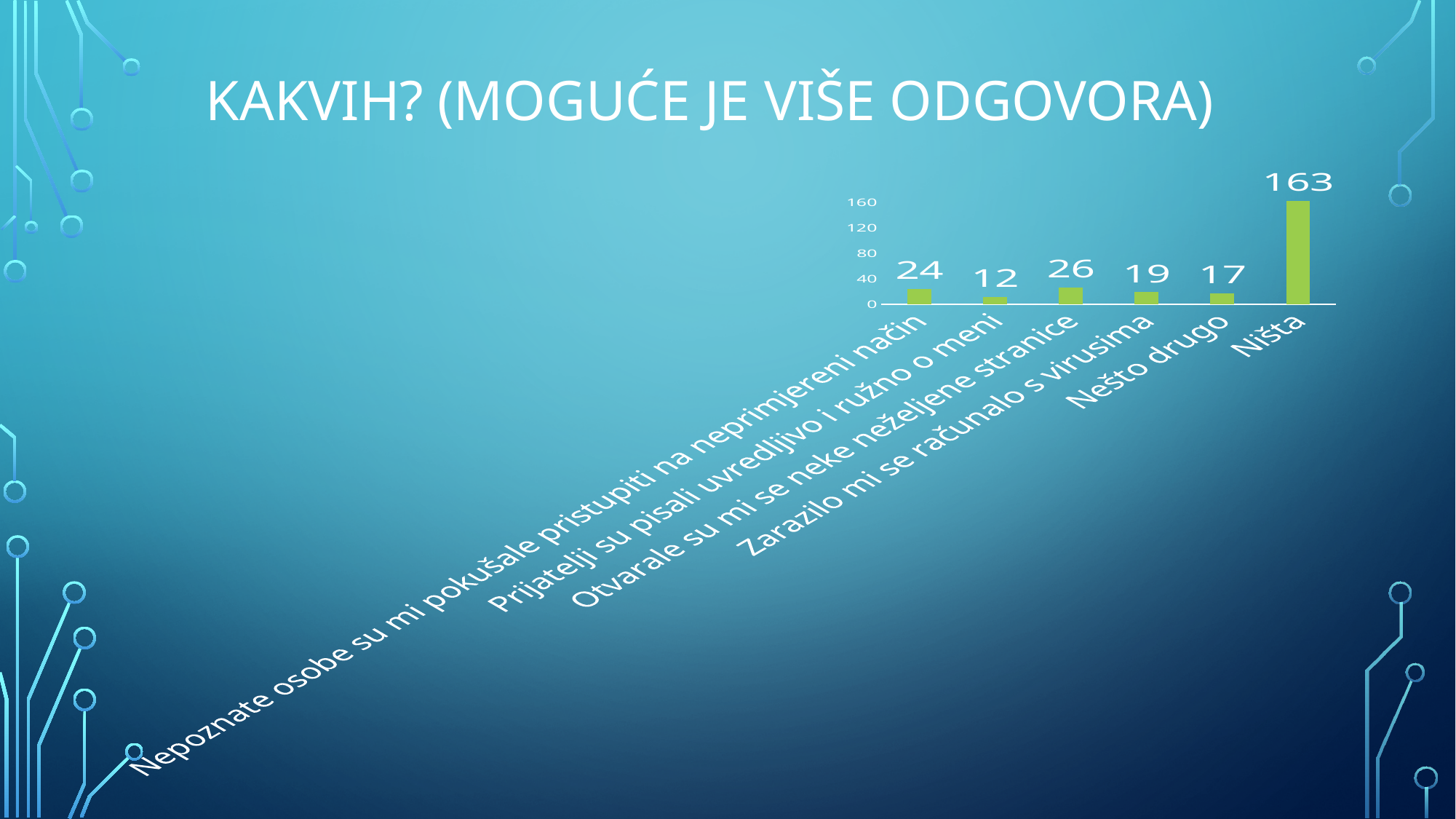
What is the value for "Zarazilo mi se računalo s virusima"? 19 What is the value for "Prijatelji su pisali uvredljivo i ružno o meni"? 12 What is the value for "Otvarale su mi se neke neželjene stranice"? 26 What is the title of the slide containing the chart? KAKVIH? (MOGUĆE JE VIŠE ODGOVORA) How many categories are shown on the chart? 6 Which is larger, the value for "Nepoznate osobe su mi pokušale pristupiti na neprimjereni način" or the value for "Nešto drugo"? Nepoznate osobe su mi pokušale pristupiti na neprimjereni način Which category has the lowest value? Prijatelji su pisali uvredljivo i ružno o meni Which category has the highest value? Ništa Is the value for "Ništa" greater or less than 120? greater What kind of chart is shown on the slide? bar chart What is the value for "Ništa"? 163 What is the difference between the values for "Ništa" and "Nepoznate osobe su mi pokušale pristupiti na neprimjereni način"? 139